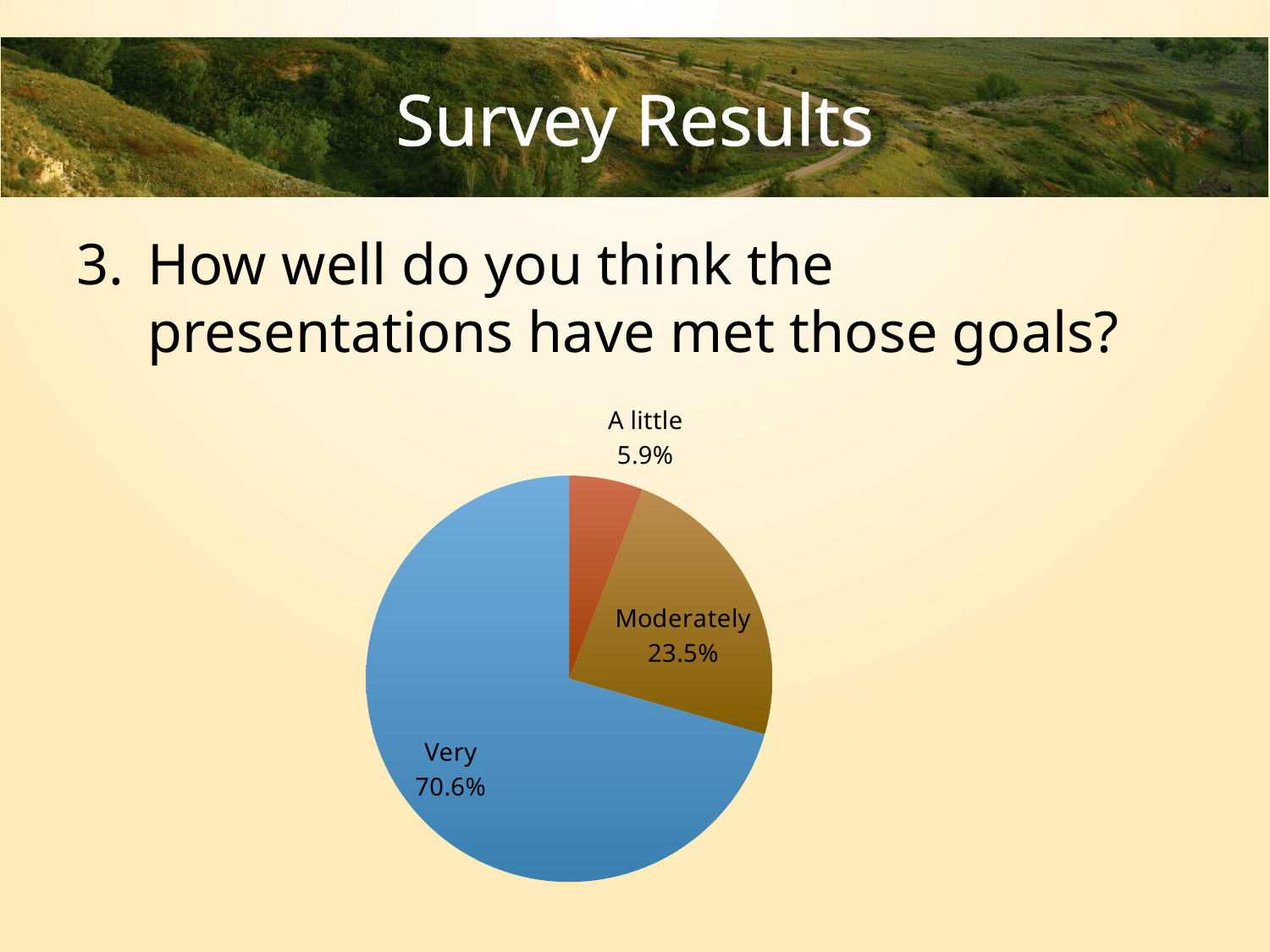
What share of respondents answered "Very"? 70.6% What survey question does the pie chart present results for? How well do you think the presentations have met those goals? What is the difference in percentage points between "Very" and "Moderately"? 47.1 How many slices does the pie chart have? 3 Which response has the smallest slice of the pie? A little What share of respondents answered "A little"? 5.9% What colour is the "Very" slice? blue Which is larger, the share for "Moderately" or the share for "A little"? Moderately What kind of chart is shown on the slide? pie chart Which response has the largest slice of the pie? Very What is the difference in percentage points between "Moderately" and "A little"? 17.6 What share of respondents answered "Moderately"? 23.5%